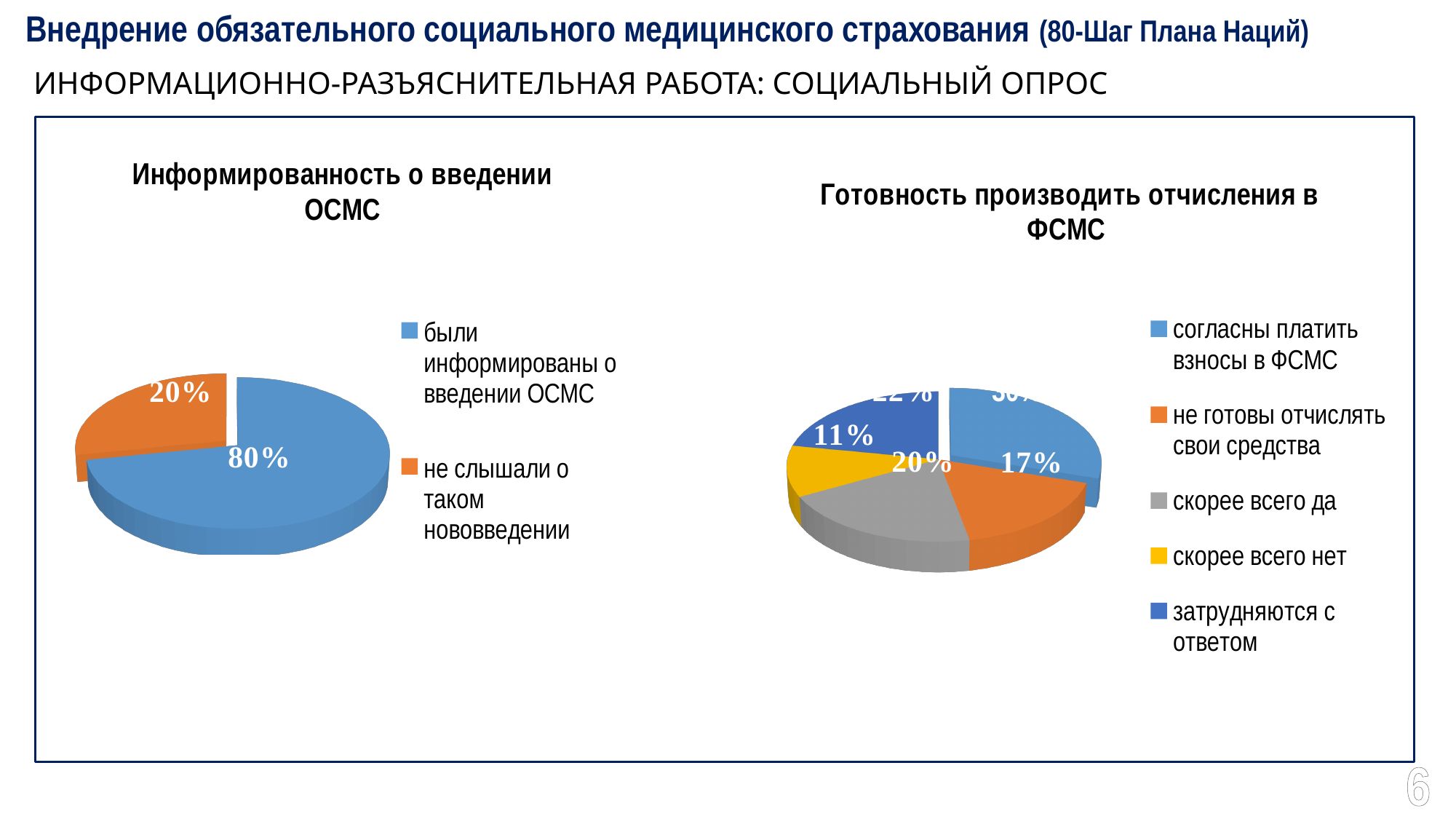
In the chart titled 'Информированность о введении ОСМС', what share of respondents had not heard of the innovation (не слышали о таком нововведении)? 20% In the chart titled 'Готовность производить отчисления в ФСМС', what share of respondents answered 'скорее всего да'? 20% How many entries does the legend of the chart 'Информированность о введении ОСМС' list? 2 In the chart titled 'Готовность производить отчисления в ФСМС', what share of respondents answered 'скорее всего нет'? 11% What type of chart is the left chart, 'Информированность о введении ОСМС'? Pie chart How many categories does the legend of the chart 'Готовность производить отчисления в ФСМС' list? 5 In the chart titled 'Информированность о введении ОСМС', which category has the larger share? были информированы о введении ОСМС In the chart titled 'Информированность о введении ОСМС', what share of respondents were informed about the introduction of ОСМС (были информированы о введении ОСМС)? 80% In the chart titled 'Готовность производить отчисления в ФСМС', which category has the smallest share? скорее всего нет In the chart titled 'Готовность производить отчисления в ФСМС', which is larger: the share for 'скорее всего да' or the share for 'не готовы отчислять свои средства'? скорее всего да In the chart titled 'Информированность о введении ОСМС', what is the difference in percentage points between those who were informed and those who had not heard? 60 percentage points In the chart titled 'Готовность производить отчисления в ФСМС', what share of respondents are not ready to contribute their funds (не готовы отчислять свои средства)? 17%